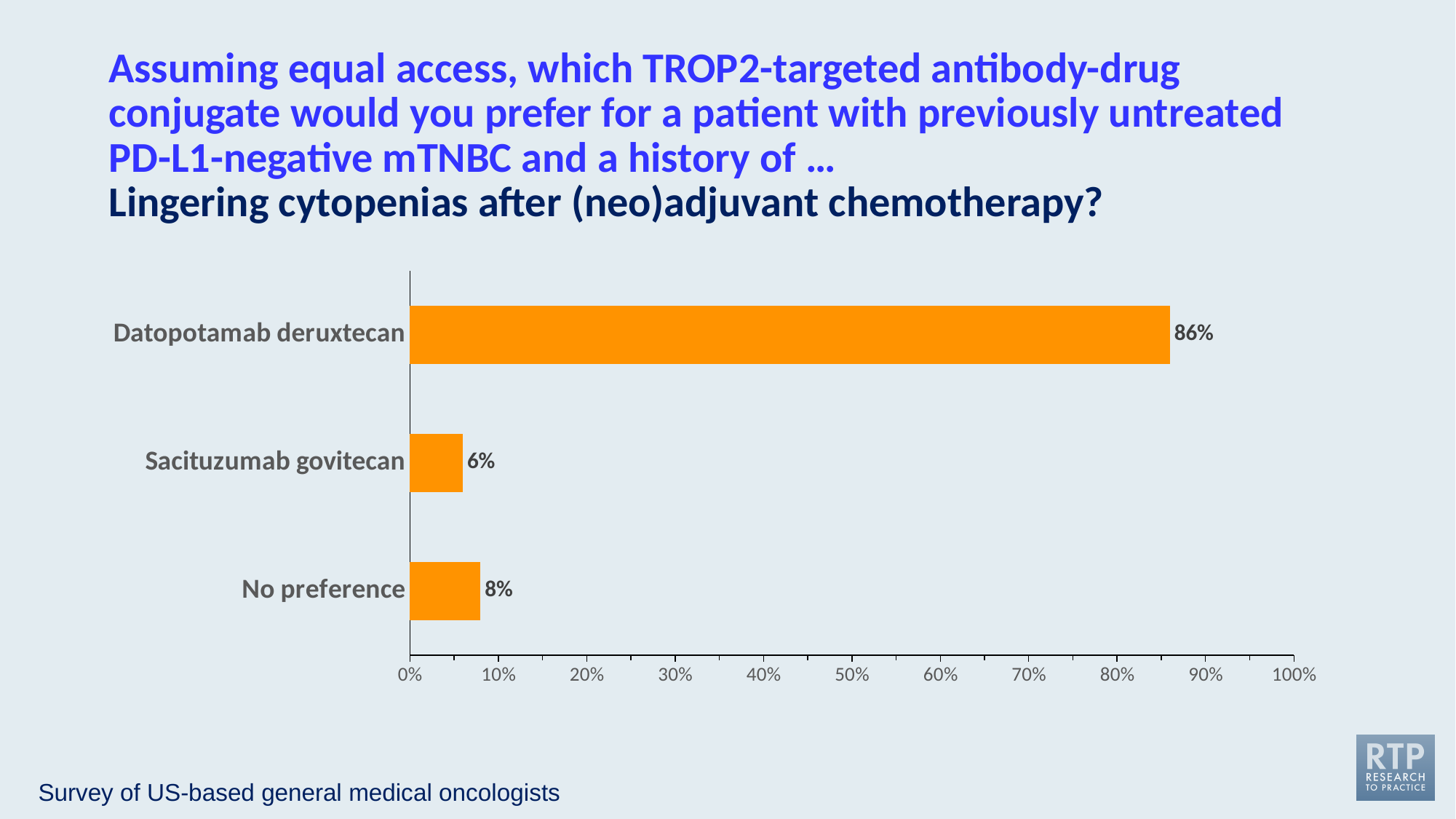
Which option received the lowest percentage of responses? Sacituzumab govitecan What is the maximum value shown on the x axis? 100% What is the difference in percentage points between 'No preference' and sacituzumab govitecan? 2 Which received a larger share of responses: sacituzumab govitecan or no preference? No preference What type of chart is shown on the slide? Bar chart What percentage of respondents preferred sacituzumab govitecan? 6% Which option received the highest percentage of responses? Datopotamab deruxtecan What percentage of respondents indicated no preference? 8% What is the difference in percentage points between datopotamab deruxtecan and sacituzumab govitecan? 80 Is the value for datopotamab deruxtecan greater or less than 80%? greater How many response options are shown in the chart? 3 What percentage of respondents preferred datopotamab deruxtecan? 86%